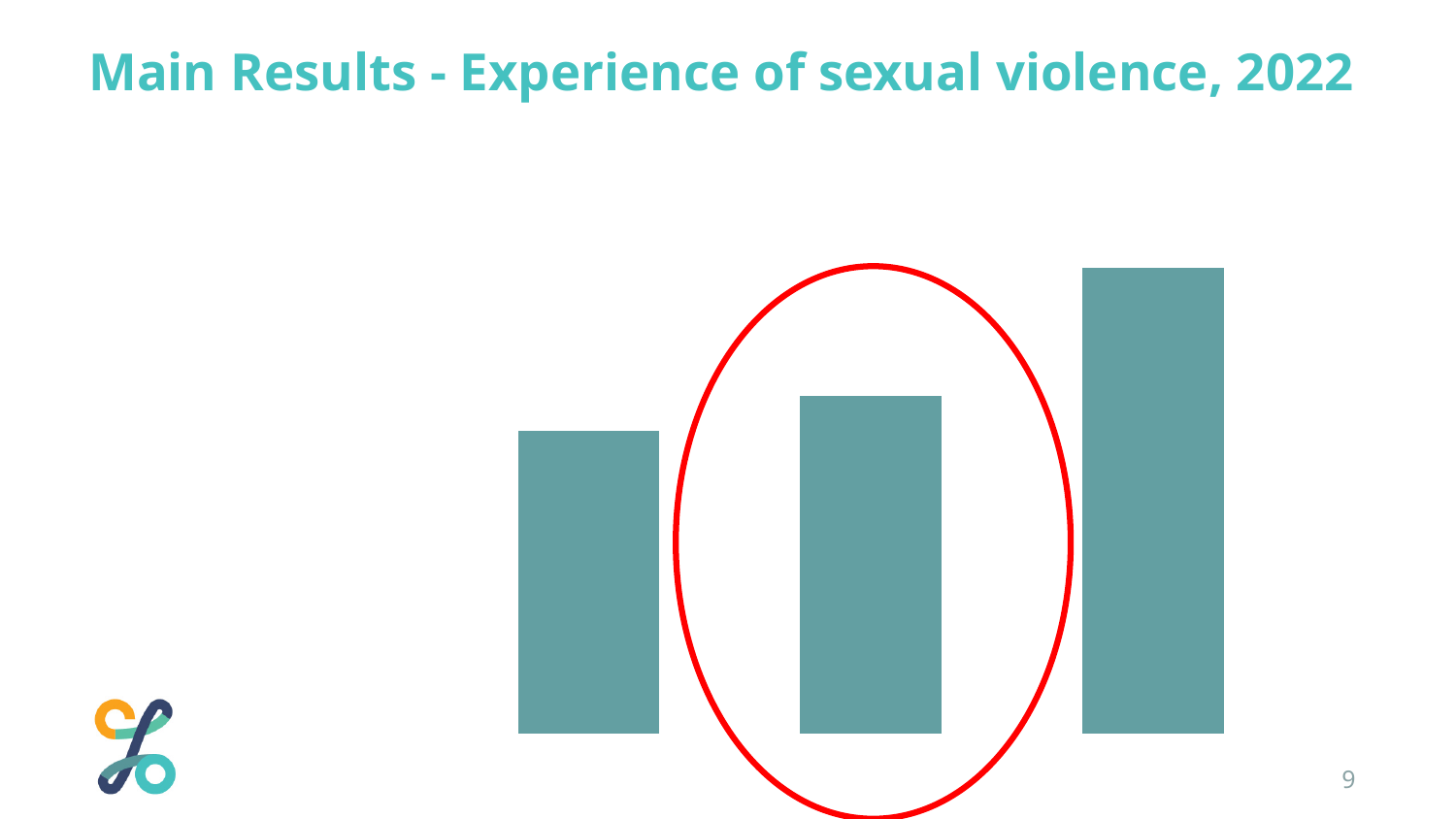
How many bars does the chart contain? 3 Which is taller, the left bar or the middle bar? middle bar Which bar is the tallest: the left, middle or right bar? right What is the title of the slide containing the chart? Main Results - Experience of sexual violence, 2022 Which is taller, the middle bar or the right bar? right bar Which bar is the shortest: the left, middle or right bar? left Which bar is highlighted with a red circle: the left, middle or right bar? middle Do the bar heights rise or fall from left to right across the chart? rise What kind of chart is shown on the slide? bar chart